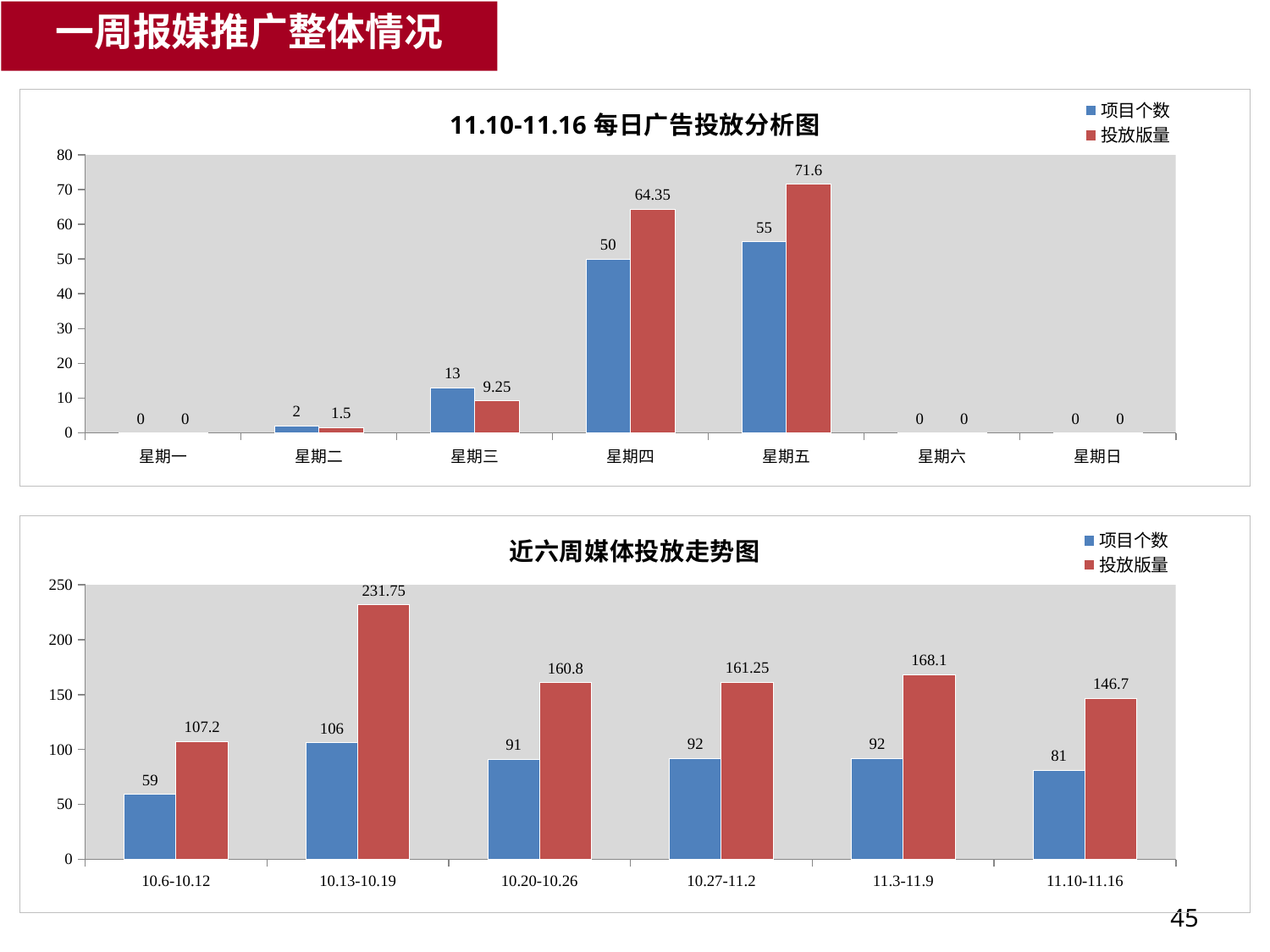
In the top chart (11.10-11.16 每日广告投放分析图), what is the 投放版量 value for 星期五? 71.6 In the top chart (11.10-11.16 每日广告投放分析图), which day has the highest 投放版量? 星期五 In the top chart (11.10-11.16 每日广告投放分析图), is the 项目个数 value for 星期四 greater or less than 40? greater What type of chart is the bottom chart (近六周媒体投放走势图)? Bar chart In the bottom chart (近六周媒体投放走势图), which is larger, the 投放版量 for 11.3-11.9 or for 11.10-11.16? 11.3-11.9 In the top chart (11.10-11.16 每日广告投放分析图), how many days are shown on the x axis? 7 In the top chart (11.10-11.16 每日广告投放分析图), what is the difference between the 投放版量 values for 星期五 and 星期四? 7.25 In the bottom chart (近六周媒体投放走势图), what is the 投放版量 value for 10.13-10.19? 231.75 In the bottom chart (近六周媒体投放走势图), which week has the lowest 项目个数? 10.6-10.12 In the bottom chart (近六周媒体投放走势图), what is the difference between the 项目个数 values for 10.13-10.19 and 10.6-10.12? 47 In the top chart (11.10-11.16 每日广告投放分析图), what is the 项目个数 value for 星期三? 13 In the bottom chart (近六周媒体投放走势图), how many series does the legend list? 2